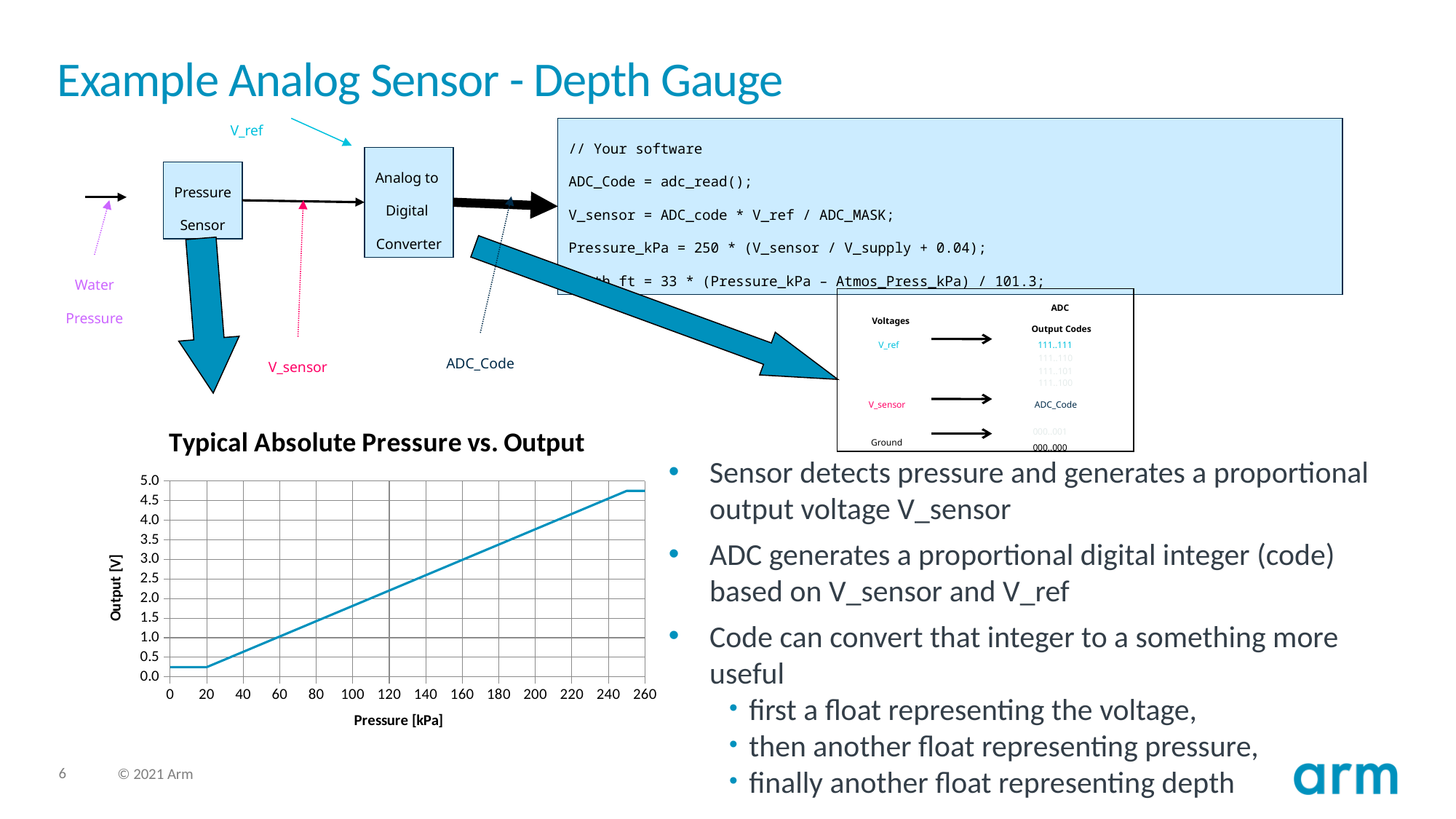
In the chart, is the output at 200 kPa greater or less than 3.5 V? greater In the chart, is the output at 100 kPa greater or less than 1.5 V? greater In the chart, does the output voltage rise or fall as pressure increases from 20 kPa to 240 kPa? rise How many tick labels are shown on the x axis of the chart? 14 What kind of chart is 'Typical Absolute Pressure vs. Output'? line chart What is the title of the chart on the slide? Typical Absolute Pressure vs. Output What is the label of the x axis of the chart? Pressure [kPa] In the chart, which is larger: the output at 200 kPa or the output at 100 kPa? 200 kPa In the chart, is the output at 60 kPa greater or less than 1.5 V? less What is the highest value labelled on the y axis of the chart? 5.0